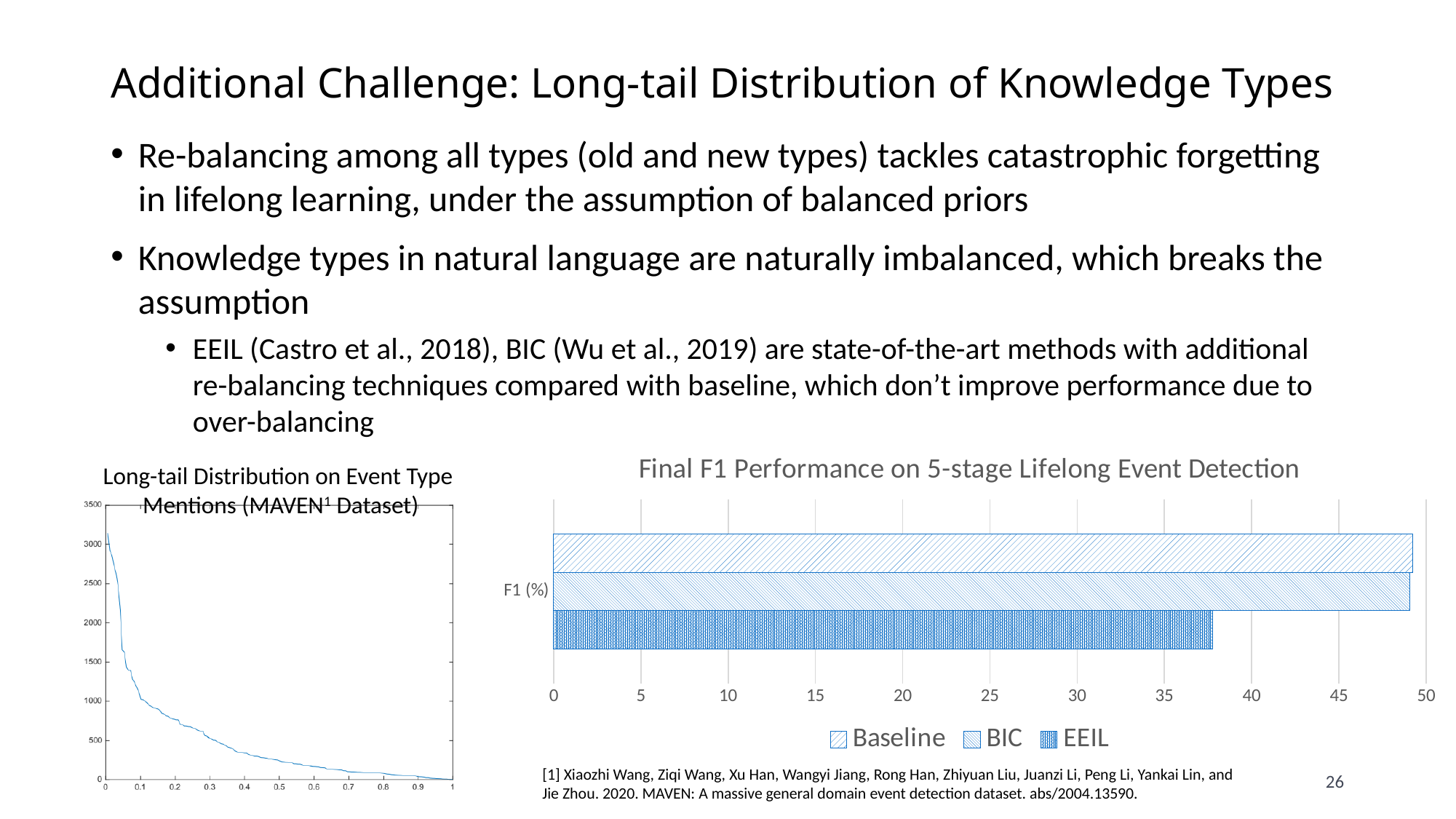
In the 'Final F1 Performance on 5-stage Lifelong Event Detection' chart, is the value for Baseline greater or less than 45? greater In the 'Long-tail Distribution on Event Type Mentions' chart on the left, do the values rise or fall along the x axis? fall In the 'Final F1 Performance on 5-stage Lifelong Event Detection' chart, what is the highest value shown on the horizontal axis? 50 In the 'Final F1 Performance on 5-stage Lifelong Event Detection' chart, which series has the lowest F1 value? EEIL In the 'Final F1 Performance on 5-stage Lifelong Event Detection' chart, what are the legend entries? Baseline, BIC, EEIL In the 'Final F1 Performance on 5-stage Lifelong Event Detection' chart, is the value for EEIL greater or less than 35? greater In the 'Final F1 Performance on 5-stage Lifelong Event Detection' chart, which is larger, the value for Baseline or the value for EEIL? Baseline In the 'Final F1 Performance on 5-stage Lifelong Event Detection' chart, how many series does the legend list? 3 What kind of chart is the 'Long-tail Distribution on Event Type Mentions' chart on the left of the slide? line chart What kind of chart is the 'Final F1 Performance on 5-stage Lifelong Event Detection' chart? bar chart In the 'Final F1 Performance on 5-stage Lifelong Event Detection' chart, what is the label of the category on the vertical axis? F1 (%) In the 'Final F1 Performance on 5-stage Lifelong Event Detection' chart, is the value for EEIL greater or less than 40? less